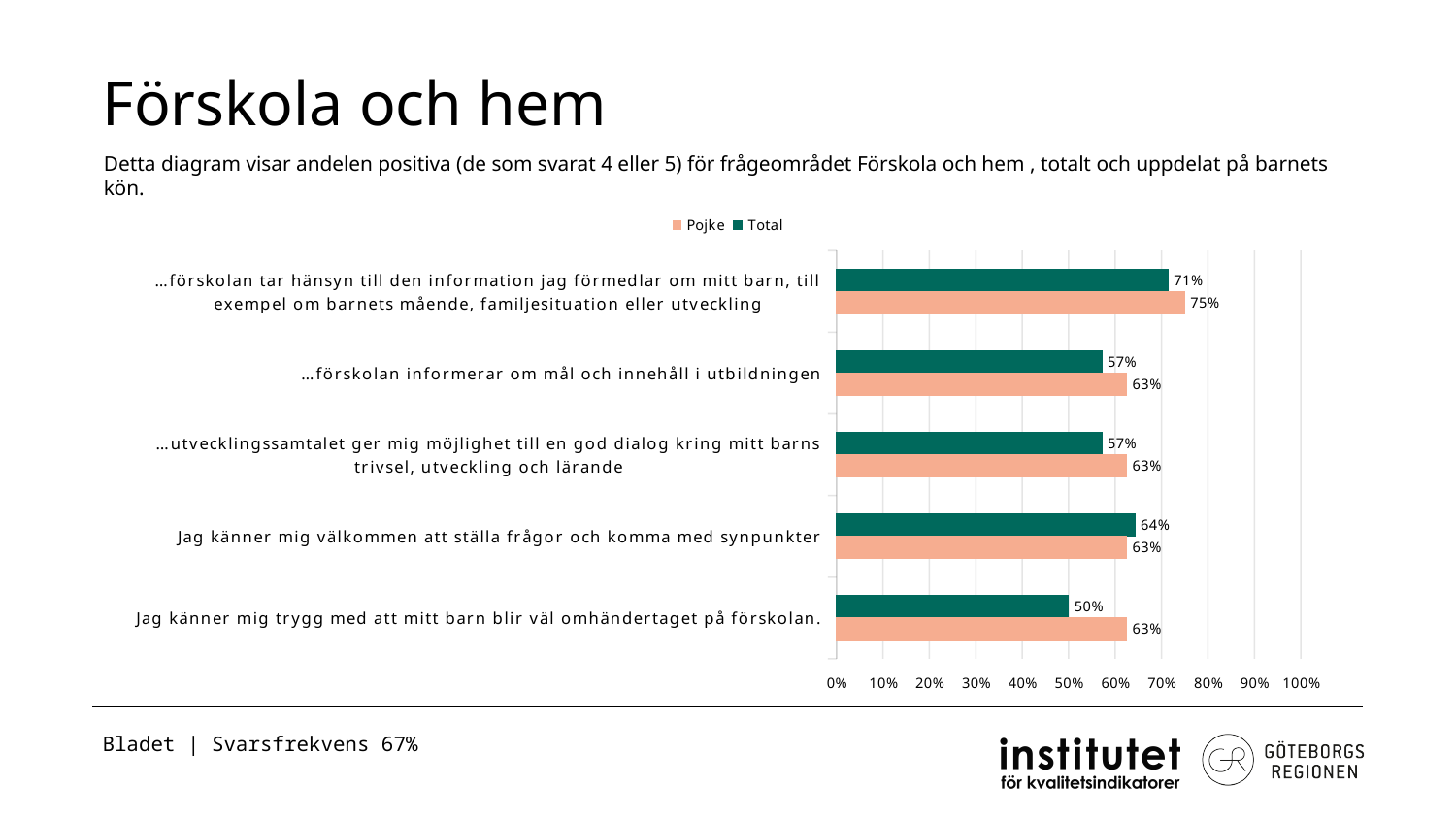
What is the Pojke value for "…förskolan tar hänsyn till den information jag förmedlar om mitt barn, till exempel om barnets mående, familjesituation eller utveckling"? 75% What kind of chart is shown on the slide? Bar chart What is the Pojke value for "Jag känner mig välkommen att ställa frågor och komma med synpunkter"? 63% For "…förskolan informerar om mål och innehåll i utbildningen", which is larger, the Pojke value or the Total value? Pojke Which category has the highest Total value? …förskolan tar hänsyn till den information jag förmedlar om mitt barn, till exempel om barnets mående, familjesituation eller utveckling Is the Total value for "…förskolan tar hänsyn till den information jag förmedlar om mitt barn, till exempel om barnets mående, familjesituation eller utveckling" greater or less than 60%? greater Which category has the lowest Total value? Jag känner mig trygg med att mitt barn blir väl omhändertaget på förskolan. How many categories are shown in the chart? 5 What is the Total value for "…förskolan informerar om mål och innehåll i utbildningen"? 57% What is the difference between the Pojke and Total values for "Jag känner mig trygg med att mitt barn blir väl omhändertaget på förskolan."? 13 percentage points How many series does the legend list? 2 What is the Total value for "Jag känner mig trygg med att mitt barn blir väl omhändertaget på förskolan."? 50%